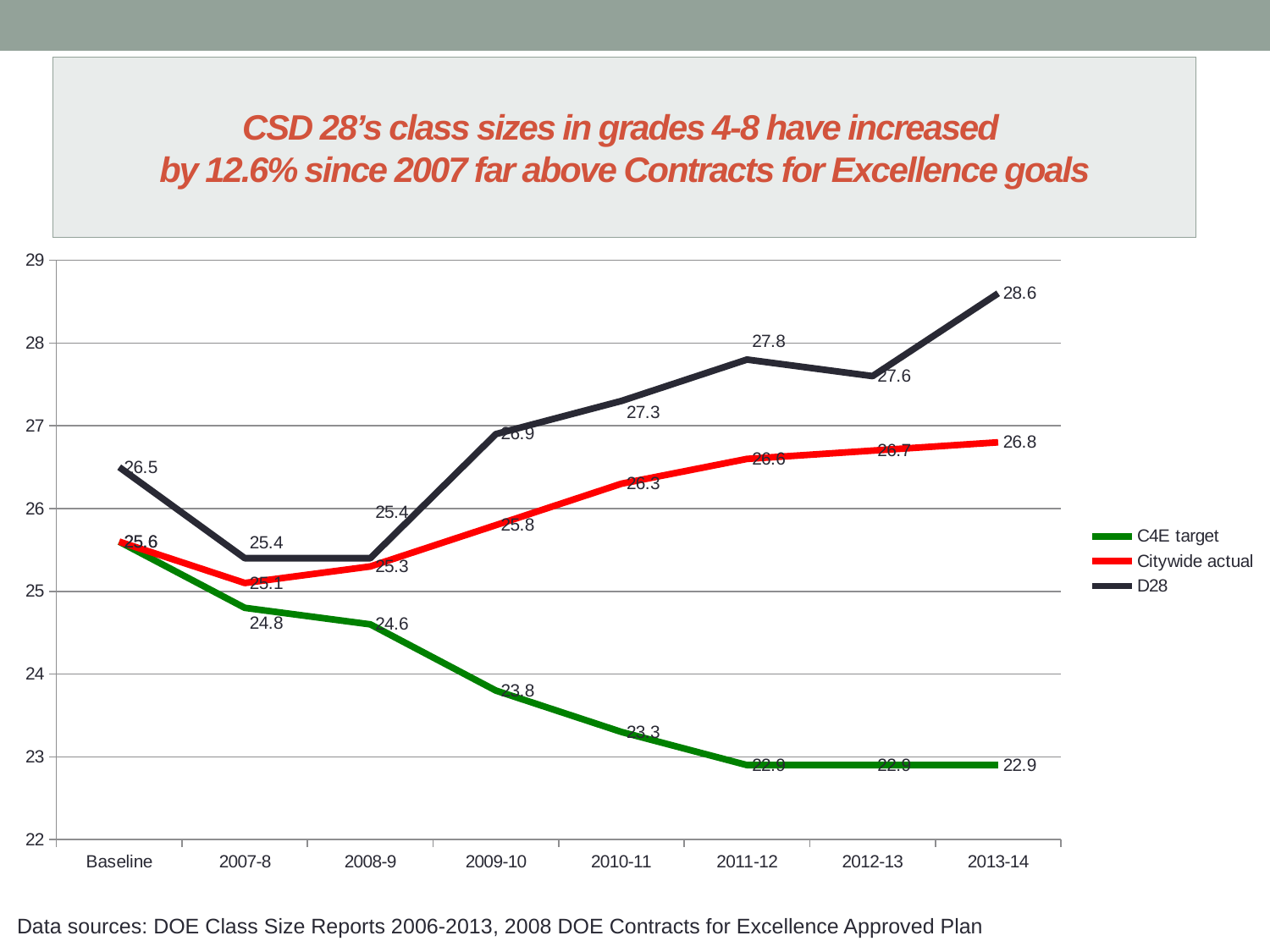
What is the D28 value for 2013-14? 28.6 In which year is the Citywide actual series at its lowest value? 2007-8 What is the difference between the D28 value and the C4E target value in 2013-14? 5.7 Does the C4E target series rise or fall from Baseline to 2013-14? fall How many series does the legend list? 3 What is the C4E target value for 2008-9? 24.6 In which year does the D28 series reach its highest value? 2013-14 How many points are plotted along the x axis for each series? 8 Which is larger in 2010-11, the D28 value or the Citywide actual value? D28 Is the D28 value for 2011-12 greater or less than 27? greater What is the Citywide actual value for 2013-14? 26.8 What kind of chart is shown on the slide? line chart